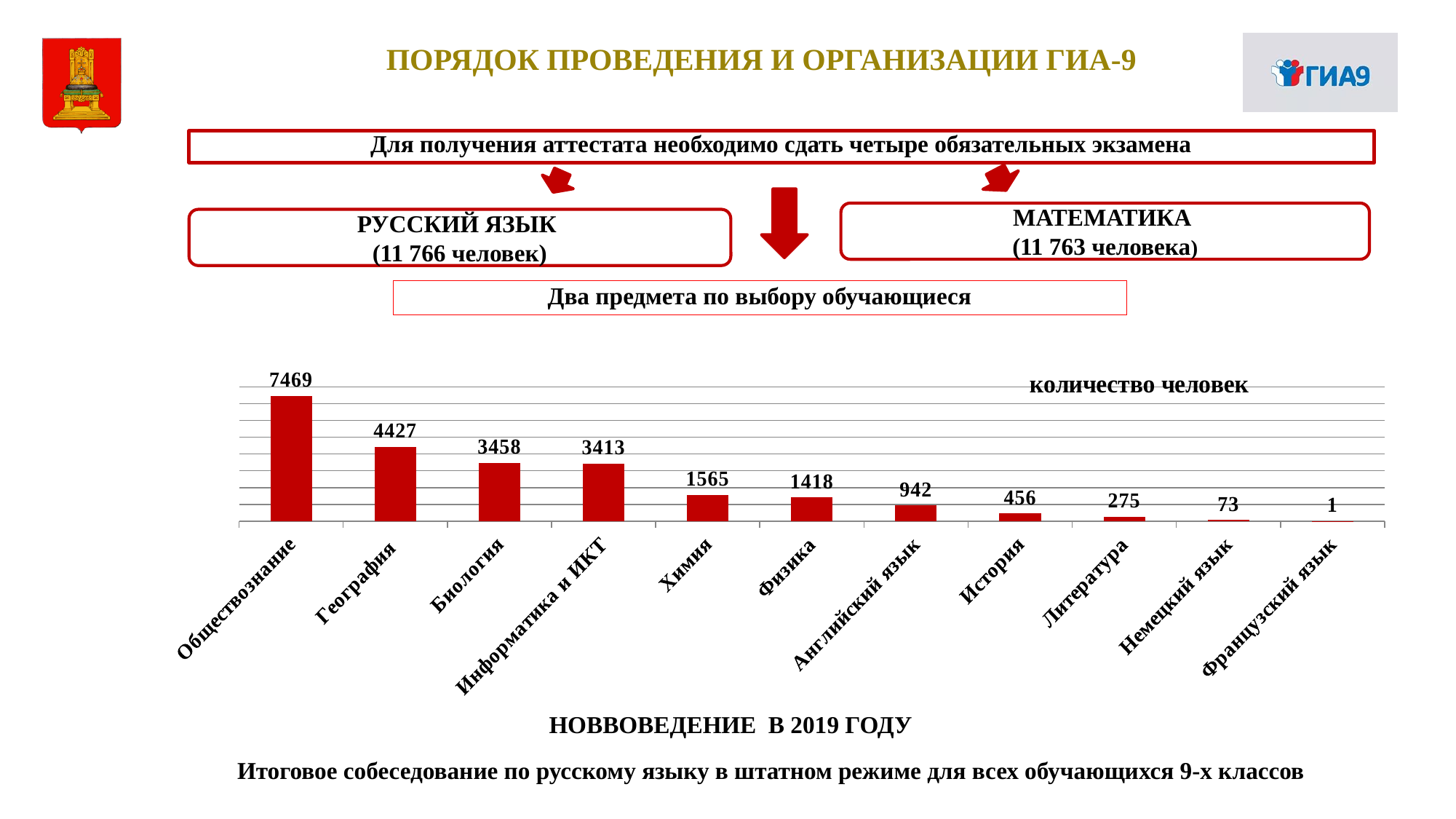
How many subjects are shown on the chart? 11 Which subject has the highest value? Обществознание What kind of chart is shown on the slide? Bar chart What is the value for Обществознание? 7469 What is the difference between the values for Химия and Физика? 147 What is the difference between the values for Обществознание and География? 3042 Which subject has the lowest value? Французский язык What is the value for Английский язык? 942 What is the series label shown at the top right of the chart? количество человек Which is larger, the value for История or the value for Литература? История What is the value for Немецкий язык? 73 What is the value for Информатика и ИКТ? 3413